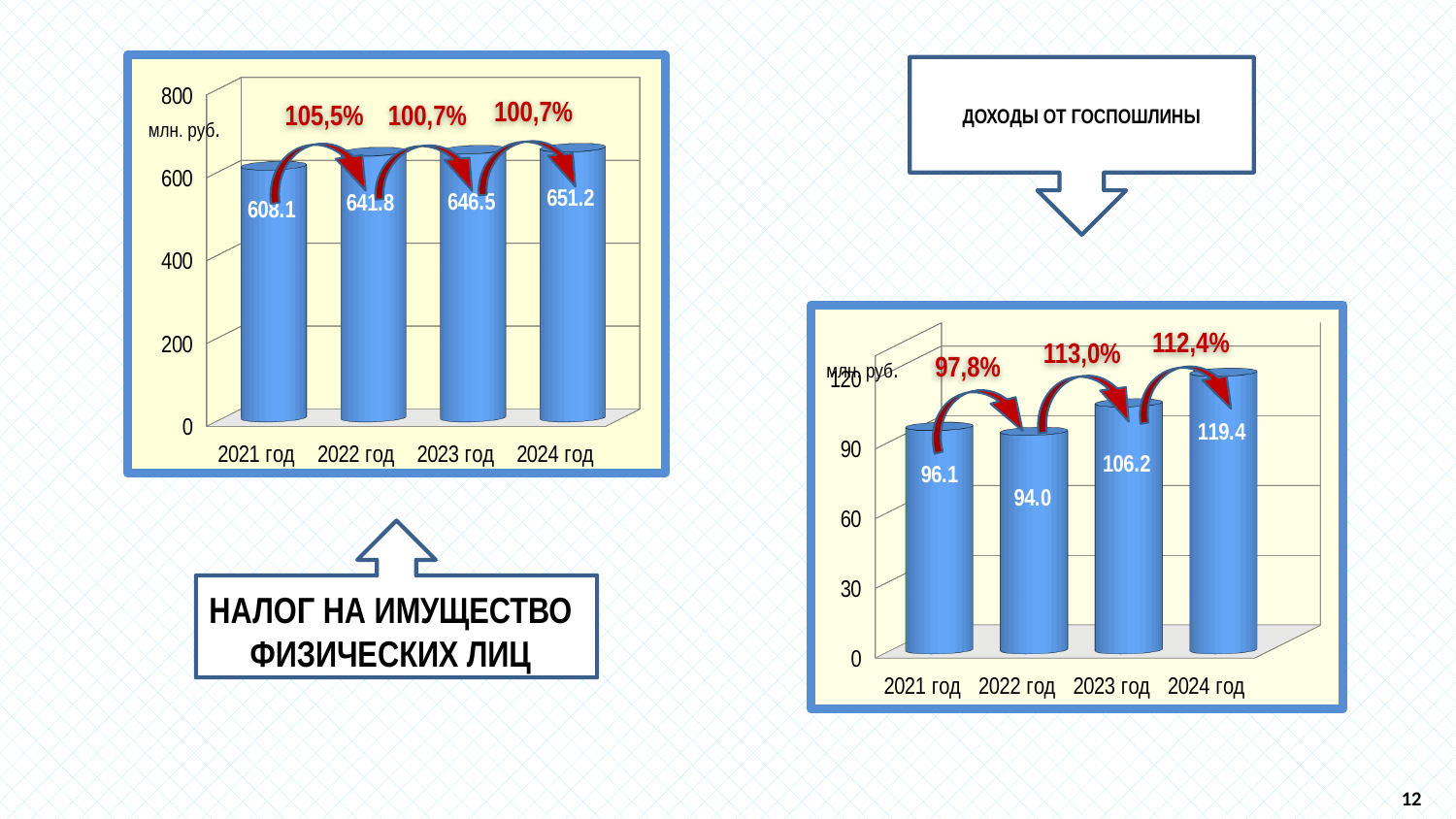
What kind of chart is the one titled НАЛОГ НА ИМУЩЕСТВО ФИЗИЧЕСКИХ ЛИЦ? bar chart In the chart titled ДОХОДЫ ОТ ГОСПОШЛИНЫ, which year has the lowest value? 2022 год In the chart titled НАЛОГ НА ИМУЩЕСТВО ФИЗИЧЕСКИХ ЛИЦ, do the values rise or fall from 2021 год to 2024 год? rise In the chart titled ДОХОДЫ ОТ ГОСПОШЛИНЫ, what is the value for 2023 год? 106.2 In the chart titled ДОХОДЫ ОТ ГОСПОШЛИНЫ, which is larger, the value for 2021 год or 2022 год? 2021 год In the chart titled НАЛОГ НА ИМУЩЕСТВО ФИЗИЧЕСКИХ ЛИЦ, how many years are shown on the x axis? 4 In the chart titled НАЛОГ НА ИМУЩЕСТВО ФИЗИЧЕСКИХ ЛИЦ, what is the value for 2024 год? 651.2 In the chart titled НАЛОГ НА ИМУЩЕСТВО ФИЗИЧЕСКИХ ЛИЦ, what is the difference between the values for 2023 год and 2022 год? 4.7 In the chart titled ДОХОДЫ ОТ ГОСПОШЛИНЫ, what is the difference between the values for 2024 год and 2023 год? 13.2 In the chart titled ДОХОДЫ ОТ ГОСПОШЛИНЫ, what percentage is shown above the arrow leading to 2022 год? 97,8% In the chart titled НАЛОГ НА ИМУЩЕСТВО ФИЗИЧЕСКИХ ЛИЦ, which year has the highest value? 2024 год In the chart titled НАЛОГ НА ИМУЩЕСТВО ФИЗИЧЕСКИХ ЛИЦ, what is the value for 2022 год? 641.8